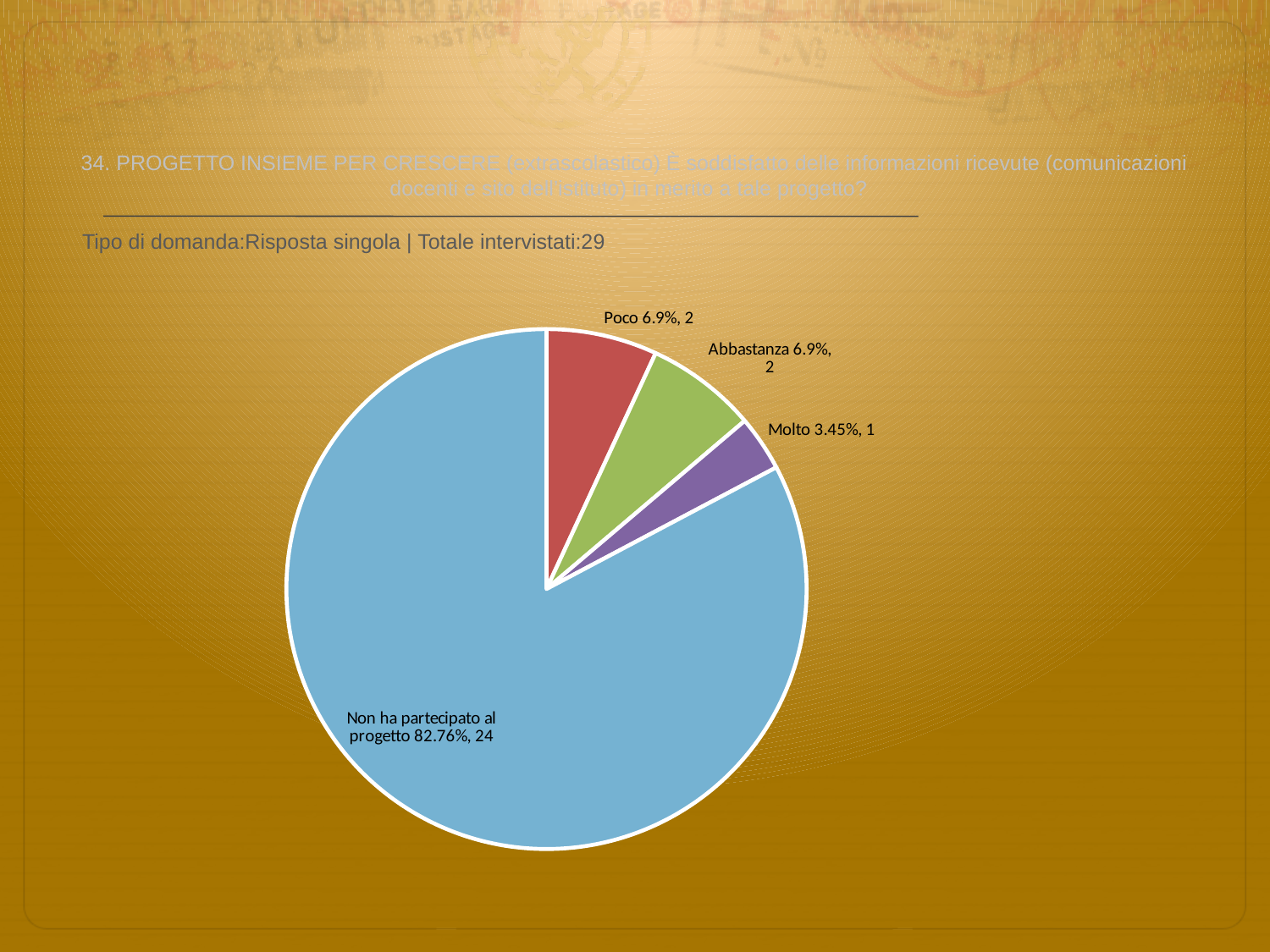
How many respondents chose 'Molto'? 1 What percentage share does the 'Non ha partecipato al progetto' slice have? 82.76% What colour is the 'Poco' slice? red What is the difference in respondent count between 'Non ha partecipato al progetto' and 'Poco'? 22 How many respondents chose 'Poco'? 2 Which category has the largest slice of the pie? Non ha partecipato al progetto Which category has the smallest slice of the pie? Molto What kind of chart is shown on the slide? pie chart What percentage share does the 'Abbastanza' slice have? 6.9% What is the total number of respondents stated on the slide? 29 How many slices does the pie chart have? 4 Which has more respondents, 'Abbastanza' or 'Molto'? Abbastanza